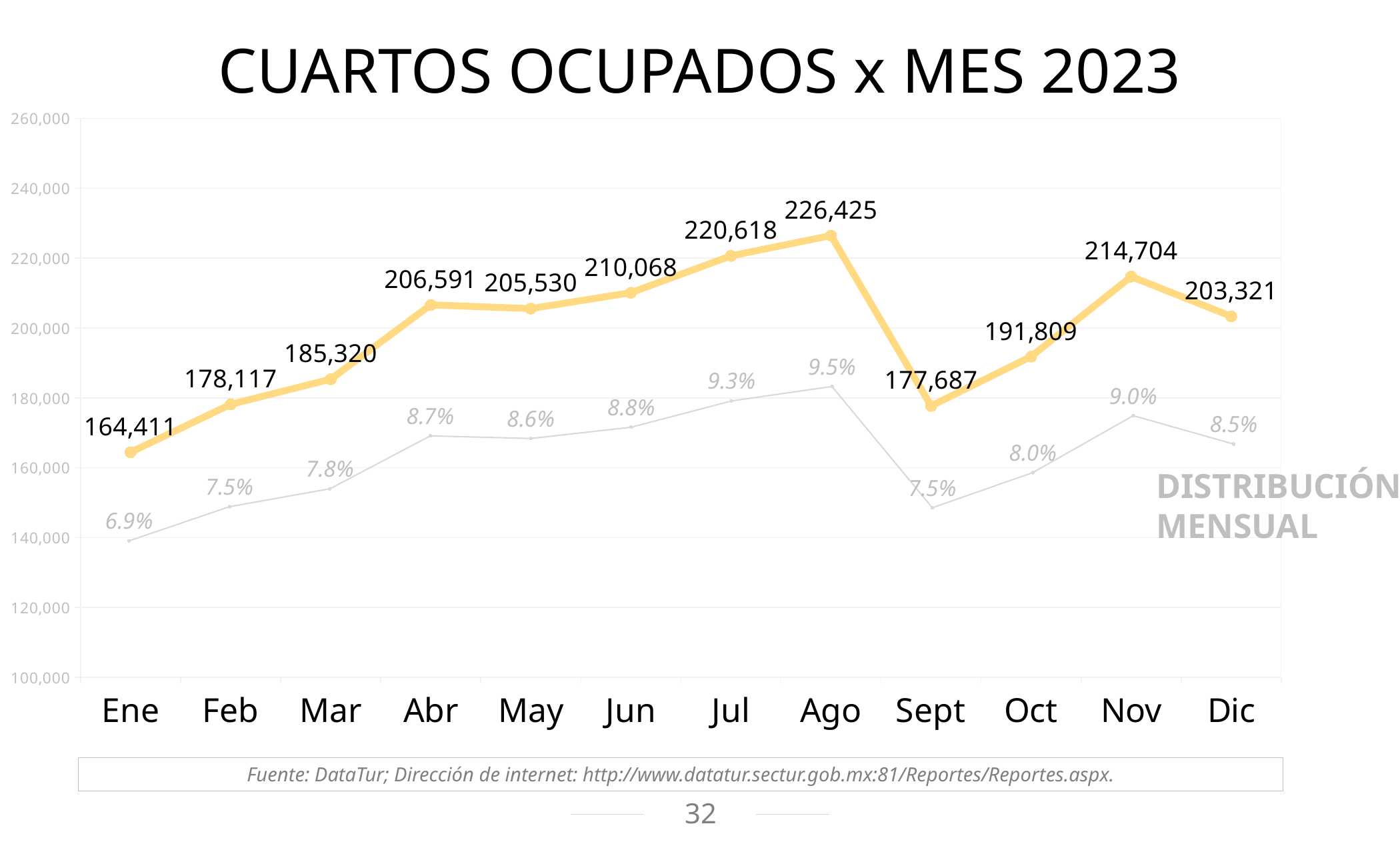
Which month has the lowest number of cuartos ocupados? Ene What type of chart is shown on the slide? line chart Which month has the highest number of cuartos ocupados? Ago What is the value of cuartos ocupados for Ago? 226,425 How many months are plotted on the x axis? 12 What is the distribución mensual percentage shown for Jul? 9.3% What is the value of cuartos ocupados for Sept? 177,687 Do the cuartos ocupados values rise or fall from Ene to Abr? rise Which month has more cuartos ocupados, Abr or May? Abr What is the difference in cuartos ocupados between Nov and Oct? 22,895 Is the value of cuartos ocupados for Mar greater or less than 200,000? less What is the difference in cuartos ocupados between Ago and Sept? 48,738